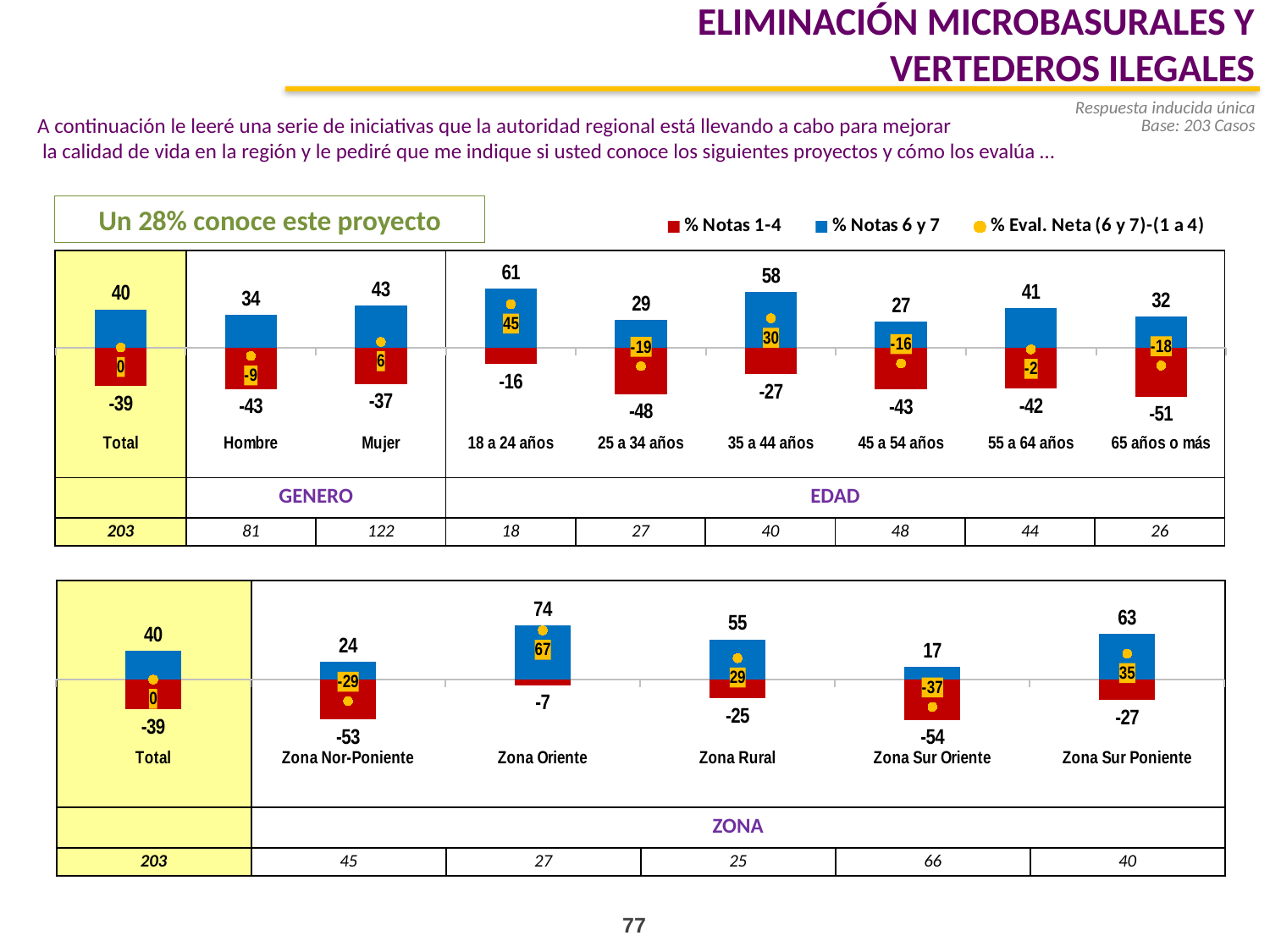
What kind of chart is the bottom chart (by zone)? Combination bar and line chart (stacked bars with dot markers for the net evaluation) How many series does the legend list for the charts? 3 In the top chart (by gender and age), what is the % Notas 6 y 7 value for 18 a 24 años? 61 In the bottom chart (by zone), which zone has the highest % Eval. Neta value? Zona Oriente In the top chart (by gender and age), which category has the lowest % Eval. Neta value? 25 a 34 años In the top chart (by gender and age), which age group has the highest % Notas 6 y 7 value? 18 a 24 años In the bottom chart (by zone), what is the % Notas 6 y 7 value for Zona Oriente? 74 In the top chart (by gender and age), what is the % Eval. Neta value for 35 a 44 años? 30 In the top chart (by gender and age), what is the % Notas 1-4 value for Mujer? -37 In the bottom chart (by zone), which is larger, the % Notas 6 y 7 value for Zona Rural or for Zona Sur Poniente? Zona Sur Poniente In the bottom chart (by zone), what is the % Notas 1-4 value for Zona Sur Oriente? -54 In the top chart (by gender and age), what is the difference between the % Notas 6 y 7 values for Mujer and Hombre? 9